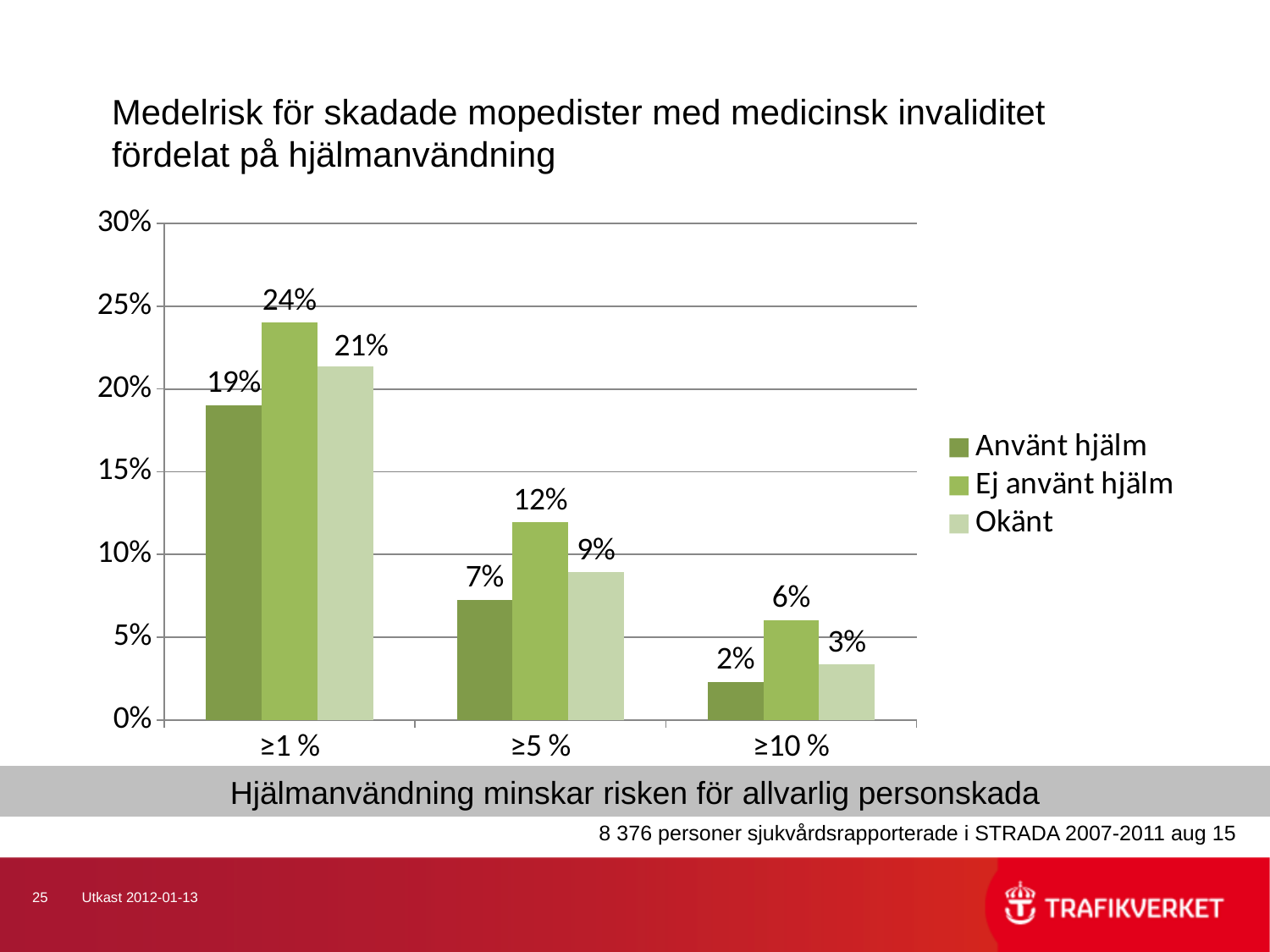
Which is larger in the ≥5 % category: "Använt hjälm" or "Okänt"? Okänt How many series does the legend list? 3 Which category has the lowest value for "Använt hjälm"? ≥10 % How many categories are shown on the x axis? 3 What is the value for "Ej använt hjälm" in the ≥5 % category? 12% Is the value for "Okänt" in the ≥1 % category greater or less than 20%? greater What is the value for "Okänt" in the ≥10 % category? 3% Do the values for "Ej använt hjälm" rise or fall from ≥1 % to ≥10 %? Fall What is the difference between "Ej använt hjälm" and "Använt hjälm" in the ≥1 % category? 5% Which category has the highest value for "Ej använt hjälm"? ≥1 % What kind of chart is shown on the slide? Bar chart What is the value for "Använt hjälm" in the ≥1 % category? 19%